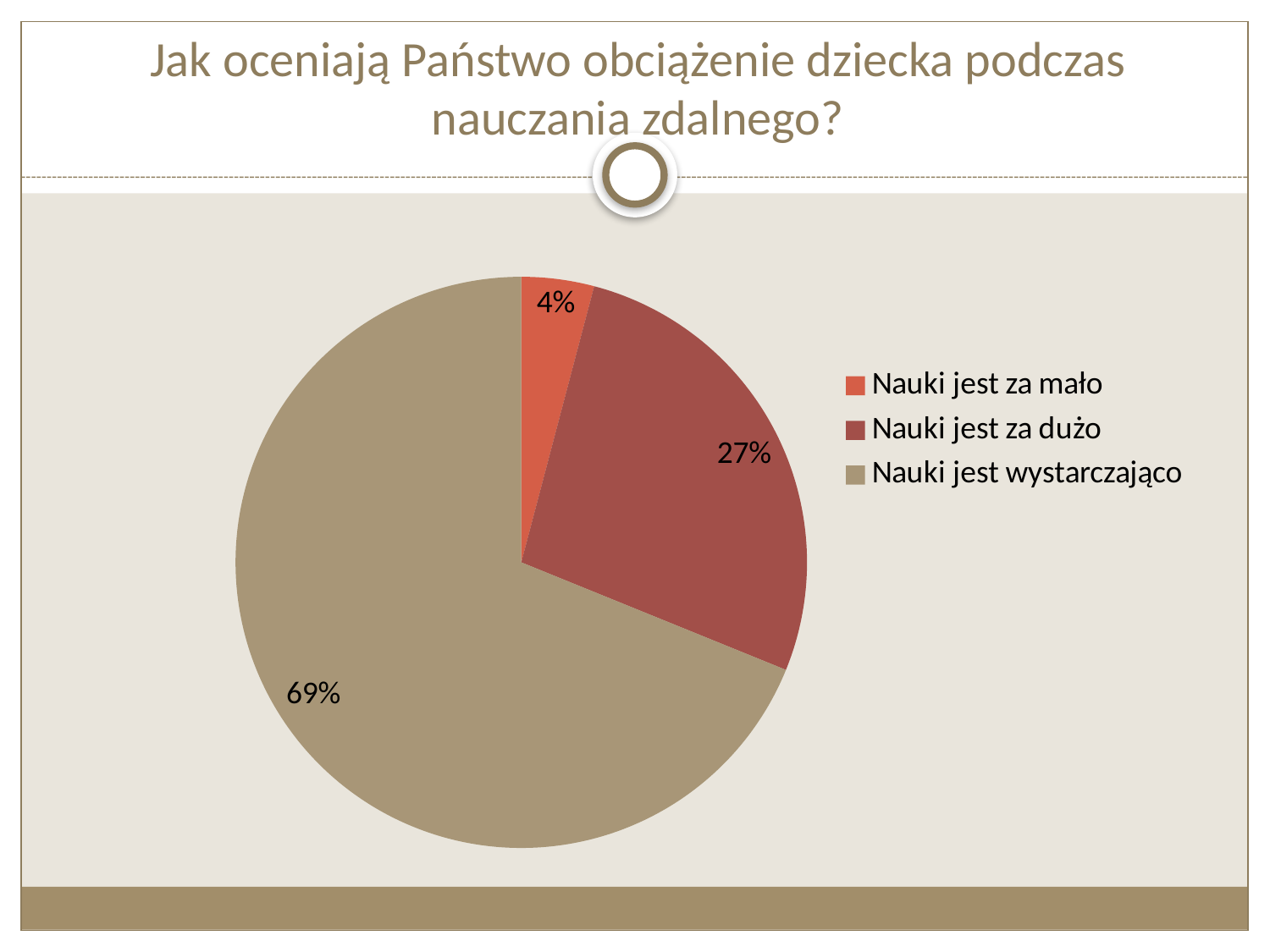
What kind of chart is shown on the slide? pie chart How many categories does the pie chart have? 3 What is the difference in percentage points between "Nauki jest za dużo" and "Nauki jest za mało"? 23 percentage points What is the title of the slide containing the chart? Jak oceniają Państwo obciążenie dziecka podczas nauczania zdalnego? What share of the pie does "Nauki jest wystarczająco" have? 69% Which category has the smallest slice of the pie? Nauki jest za mało Which is larger: the slice for "Nauki jest za dużo" or the slice for "Nauki jest za mało"? Nauki jest za dużo What share of the pie does "Nauki jest za dużo" have? 27% Which category has the largest slice of the pie? Nauki jest wystarczająco What is the difference in percentage points between "Nauki jest wystarczająco" and "Nauki jest za dużo"? 42 percentage points What share of the pie does "Nauki jest za mało" have? 4% Which legend entry is shown in orange? Nauki jest za mało